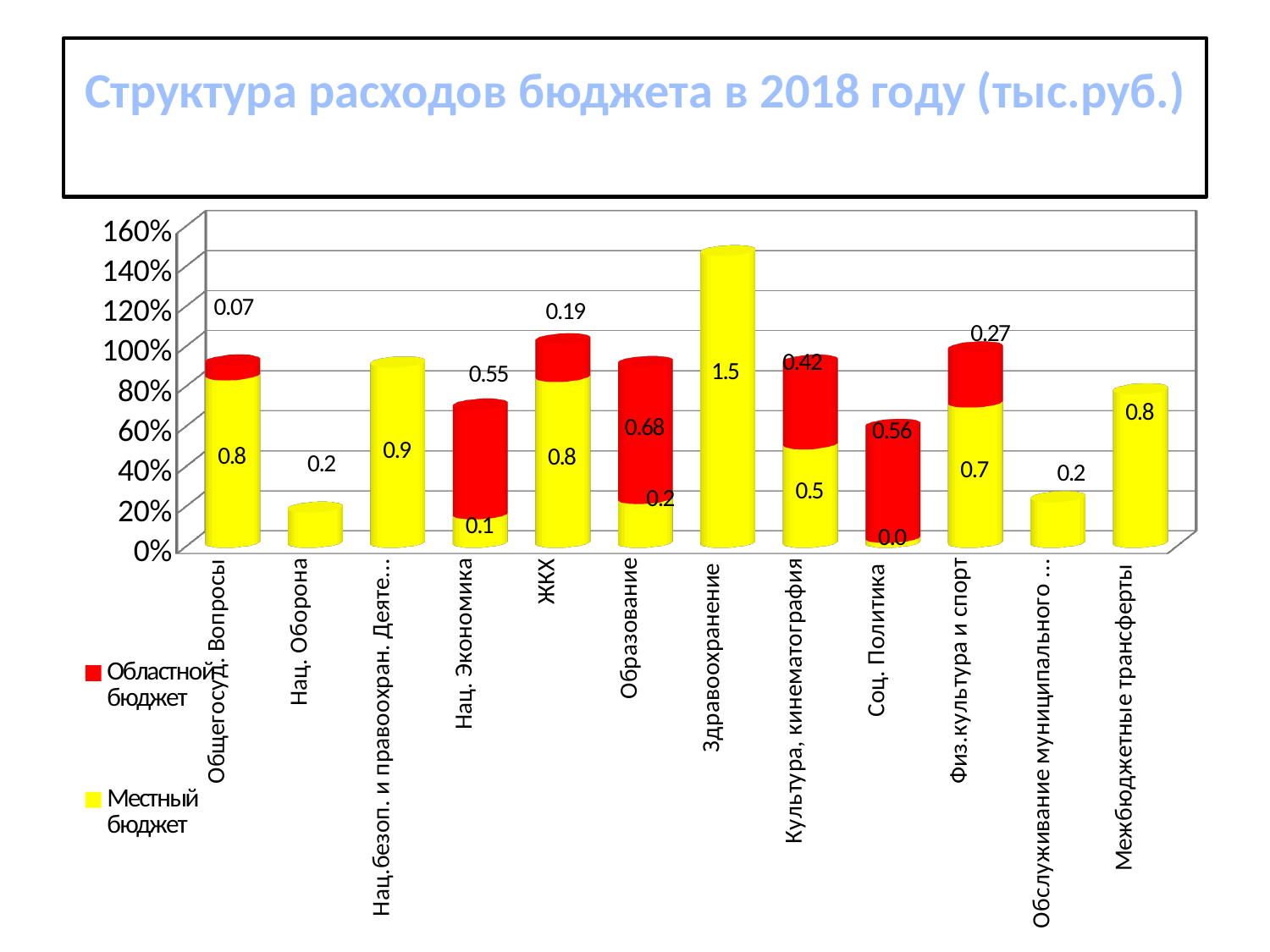
Which is larger: the Местный бюджет value for Нац.безоп. и правоохран. Деяте... or for ЖКХ? Нац.безоп. и правоохран. Деяте... What type of chart is shown on the slide? Stacked bar chart What is the value of Местный бюджет for Здравоохранение? 1.5 What is the value of Областной бюджет for Образование? 0.68 What is the difference between the Областной бюджет values for Соц. Политика and Физ.культура и спорт? 0.29 What is the total of the stacked bar for Культура, кинематография? 0.92 How many categories are shown on the x axis? 12 Which category has the highest Местный бюджет value? Здравоохранение Which category has the highest Областной бюджет value? Образование How many series does the legend list? 2 What is the value of Местный бюджет for Физ.культура и спорт? 0.7 Which colour represents Областной бюджет in the legend? Red